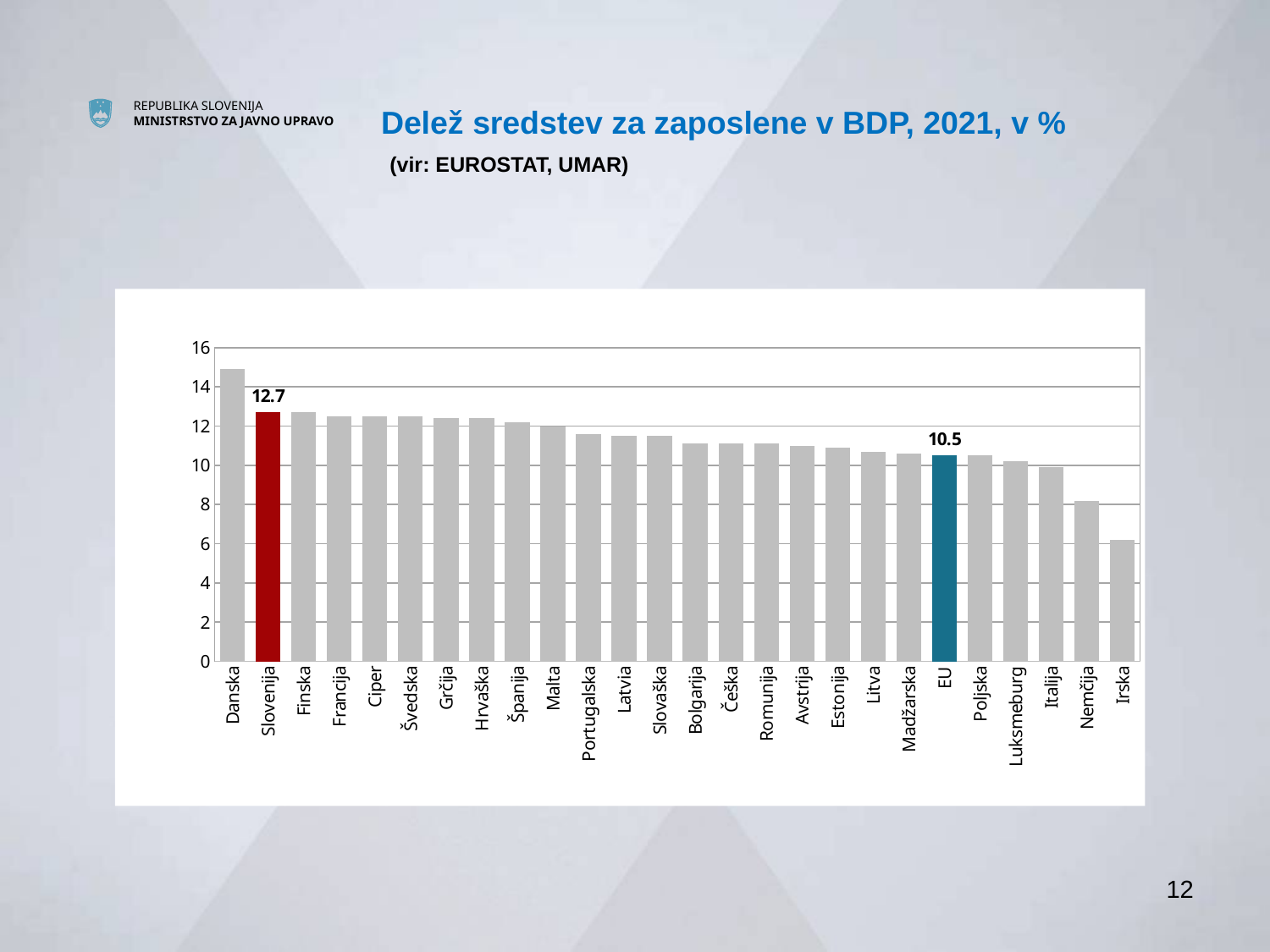
Which country has the lowest value? Irska What is the value for Slovenija? 12.7 What is the value for EU? 10.5 Is the value for Danska greater or less than 14? greater What is the difference between the values for Slovenija and EU? 2.2 Which country has the highest value? Danska Is the value for Nemčija greater or less than 10? less Do the values generally rise or fall from left to right along the x axis? Fall Which is larger, the value for Danska or the value for Irska? Danska How many bars are shown in the chart? 26 What kind of chart is shown on the slide? Bar chart Is the value for Irska greater or less than 8? less